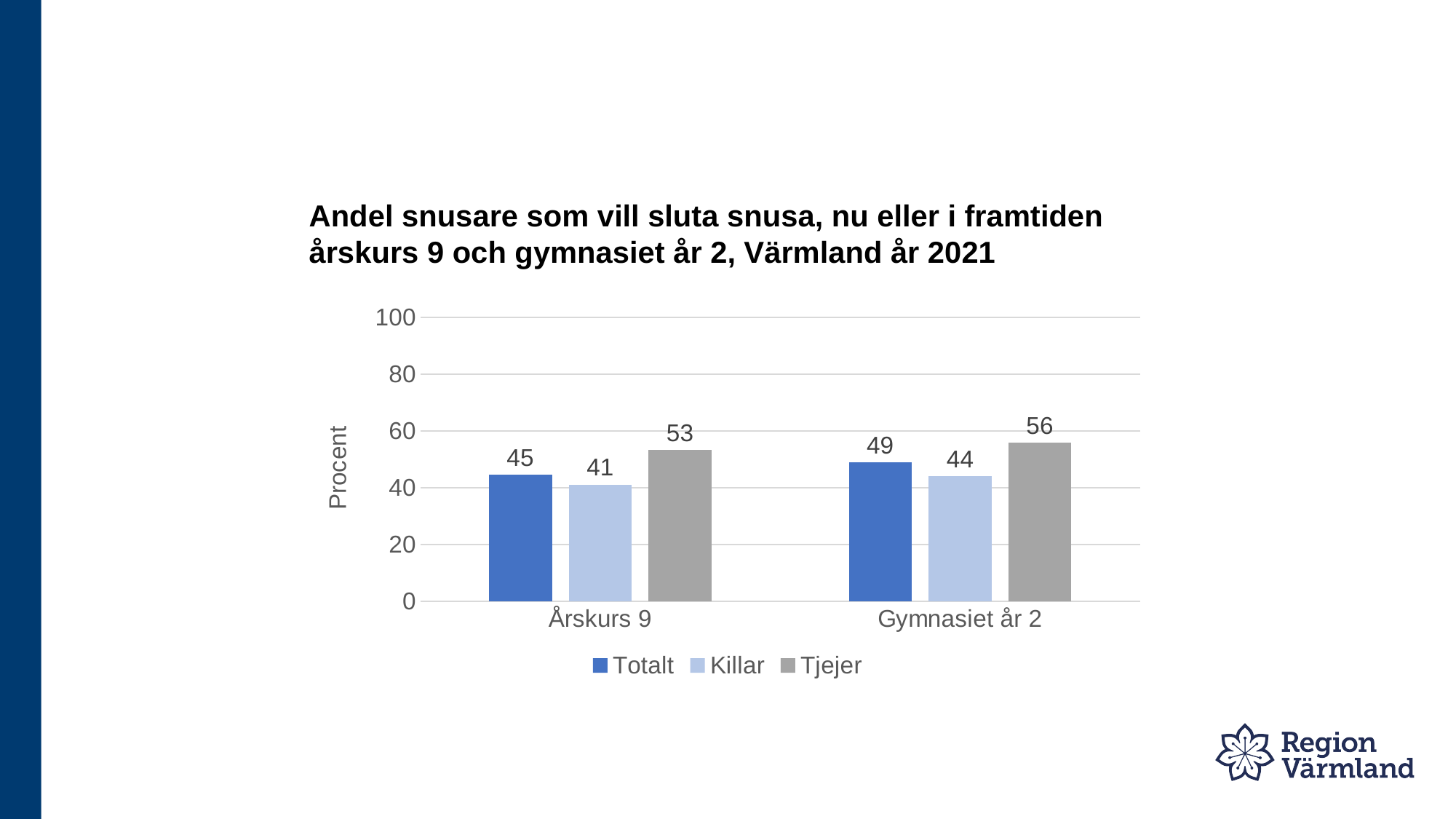
Which is larger: Tjejer in Årskurs 9 or Totalt in Gymnasiet år 2? Tjejer in Årskurs 9 What is the difference between Tjejer and Killar in Årskurs 9? 12 What is the difference between the Totalt values for Gymnasiet år 2 and Årskurs 9? 4 What is the value for Killar in Gymnasiet år 2? 44 What is the label of the y axis? Procent How many series does the legend list? 3 What is the value for Tjejer in Årskurs 9? 53 What is the value for Totalt in Årskurs 9? 45 What kind of chart is shown on the slide? Bar chart Which series has the highest value in Gymnasiet år 2? Tjejer How many categories are shown on the x axis? 2 Which series has the lowest value in Årskurs 9? Killar